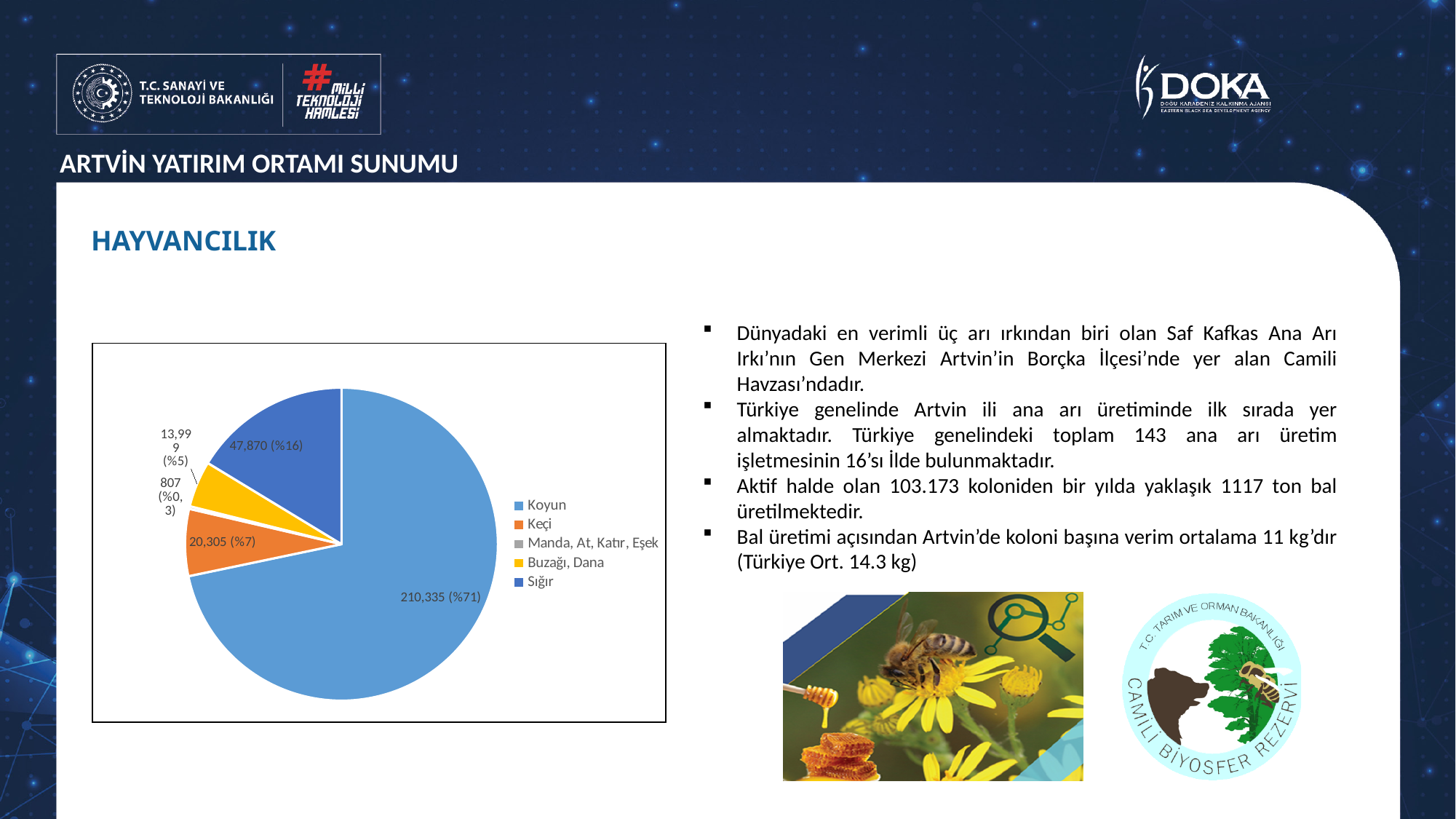
How many entries does the legend of the pie chart list? 5 What is the value shown for Koyun in the pie chart? 210,335 What is the value shown for Sığır in the pie chart? 47,870 What is the difference between the values for Koyun and Sığır? 162,465 Which category has the largest slice in the pie chart? Koyun What type of chart is shown on the slide? pie chart What is the value shown for Keçi in the pie chart? 20,305 What share of the pie does Koyun represent? %71 How many categories does the pie chart show? 5 Which is larger in the pie chart, Keçi or Sığır? Sığır What is the value shown for Buzağı, Dana in the pie chart? 13,999 Which category has the smallest slice in the pie chart? Manda, At, Katır, Eşek